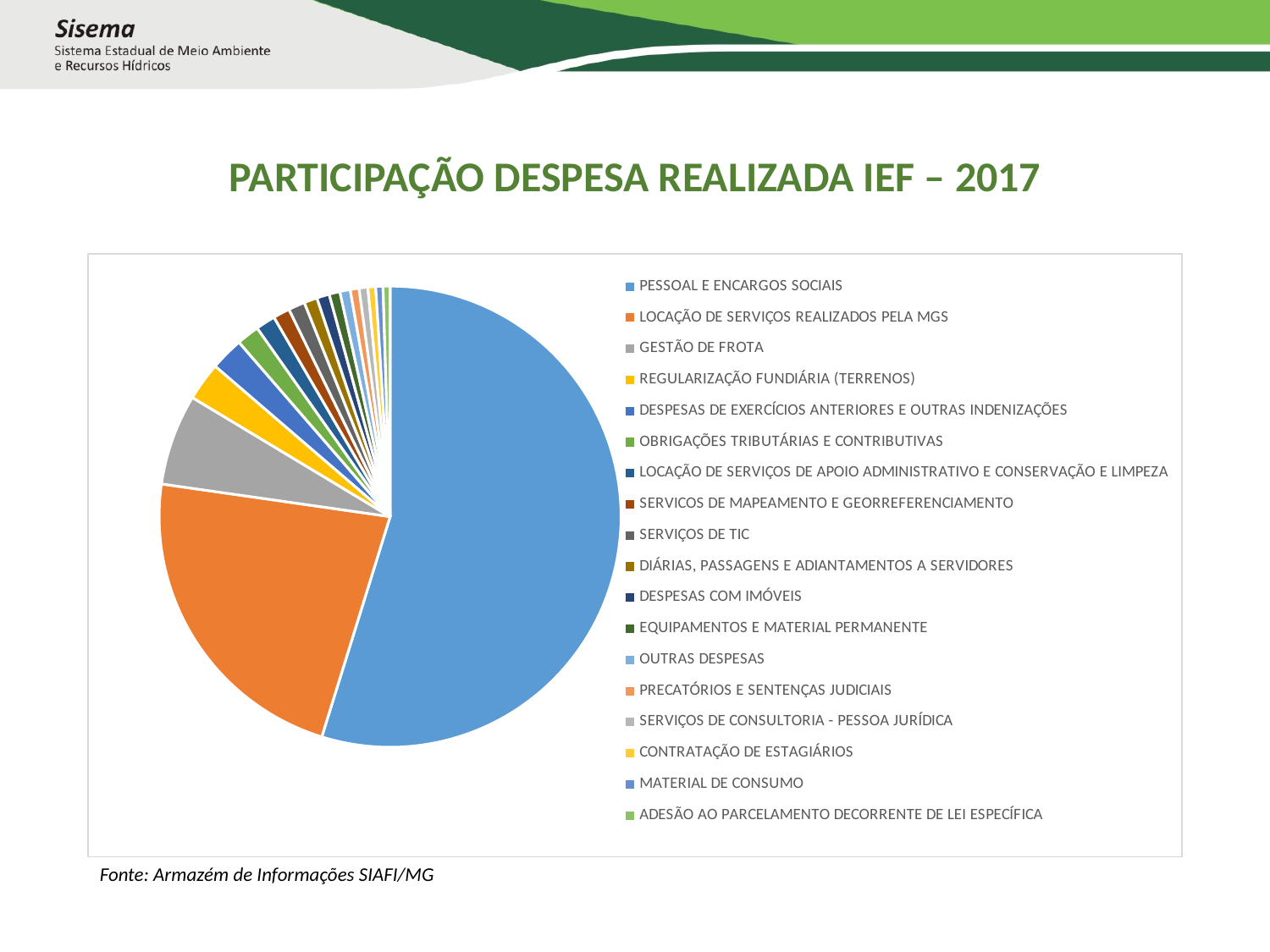
What colour is the slice for LOCAÇÃO DE SERVIÇOS REALIZADOS PELA MGS? Orange Which slice is larger: GESTÃO DE FROTA or REGULARIZAÇÃO FUNDIÁRIA (TERRENOS)? GESTÃO DE FROTA How many categories does the legend of the pie chart list? 18 Which category has the second largest slice of the pie? LOCAÇÃO DE SERVIÇOS REALIZADOS PELA MGS What kind of chart is shown on the slide? Pie chart What is the title of the chart? PARTICIPAÇÃO DESPESA REALIZADA IEF – 2017 Which category has the largest slice of the pie? PESSOAL E ENCARGOS SOCIAIS Which slice is larger: LOCAÇÃO DE SERVIÇOS REALIZADOS PELA MGS or GESTÃO DE FROTA? LOCAÇÃO DE SERVIÇOS REALIZADOS PELA MGS Does the slice for PESSOAL E ENCARGOS SOCIAIS take up more or less than half of the pie? more Which slice is larger: PESSOAL E ENCARGOS SOCIAIS or LOCAÇÃO DE SERVIÇOS REALIZADOS PELA MGS? PESSOAL E ENCARGOS SOCIAIS